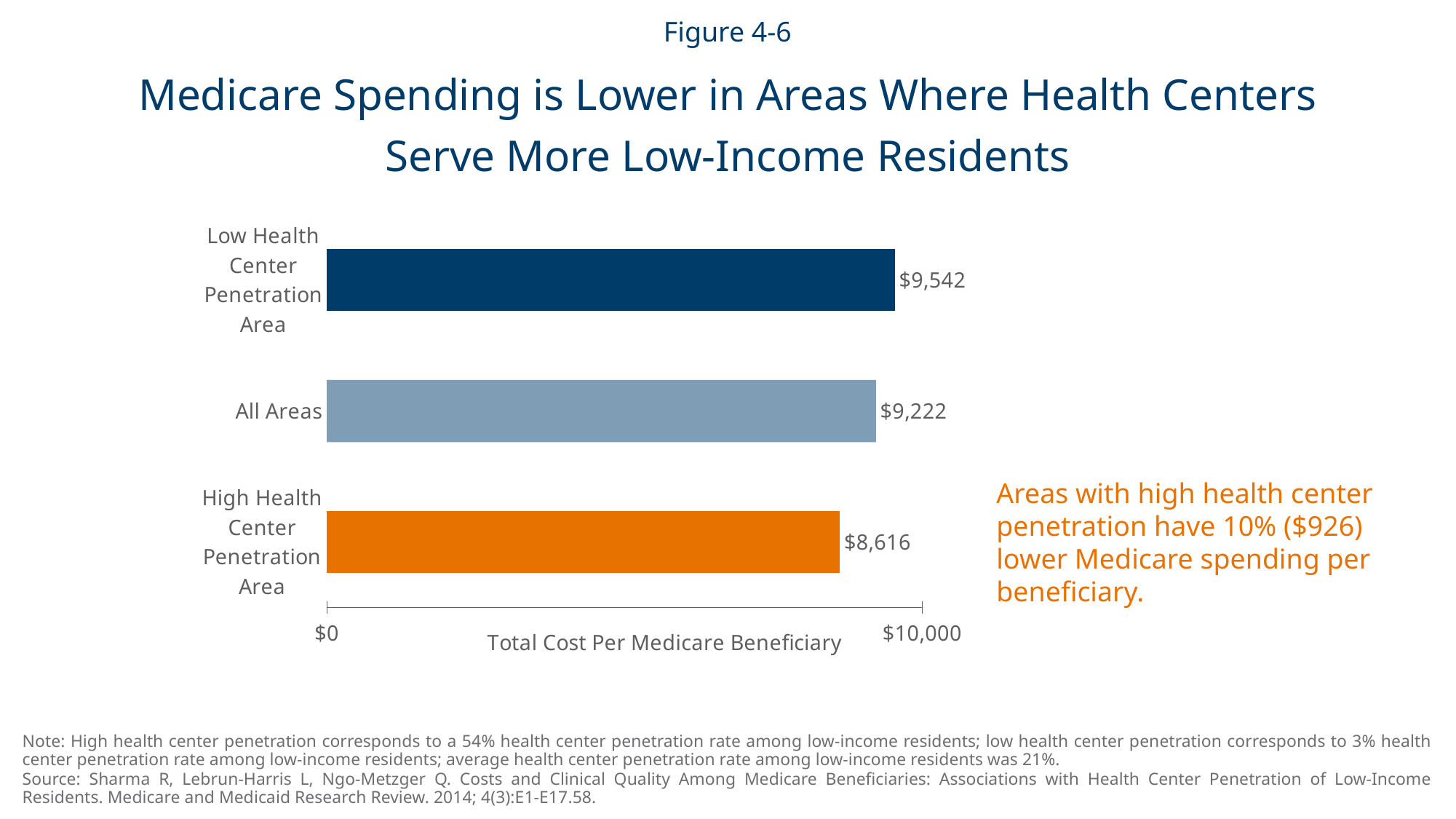
What kind of chart is shown on the slide? Bar chart What is the total cost per Medicare beneficiary in the Low Health Center Penetration Area? $9,542 What is the difference in total cost per Medicare beneficiary between All Areas and the High Health Center Penetration Area? $606 What is the total cost per Medicare beneficiary for All Areas? $9,222 Which is larger, the total cost per Medicare beneficiary for All Areas or for the High Health Center Penetration Area? All Areas How many categories are shown in the bar chart? 3 Which category has the lowest total cost per Medicare beneficiary? High Health Center Penetration Area What is the label of the x axis of the chart? Total Cost Per Medicare Beneficiary What is the difference in total cost per Medicare beneficiary between the Low Health Center Penetration Area and the High Health Center Penetration Area? $926 What is the total cost per Medicare beneficiary in the High Health Center Penetration Area? $8,616 Which category has the highest total cost per Medicare beneficiary? Low Health Center Penetration Area What colour is the bar for the High Health Center Penetration Area? Orange